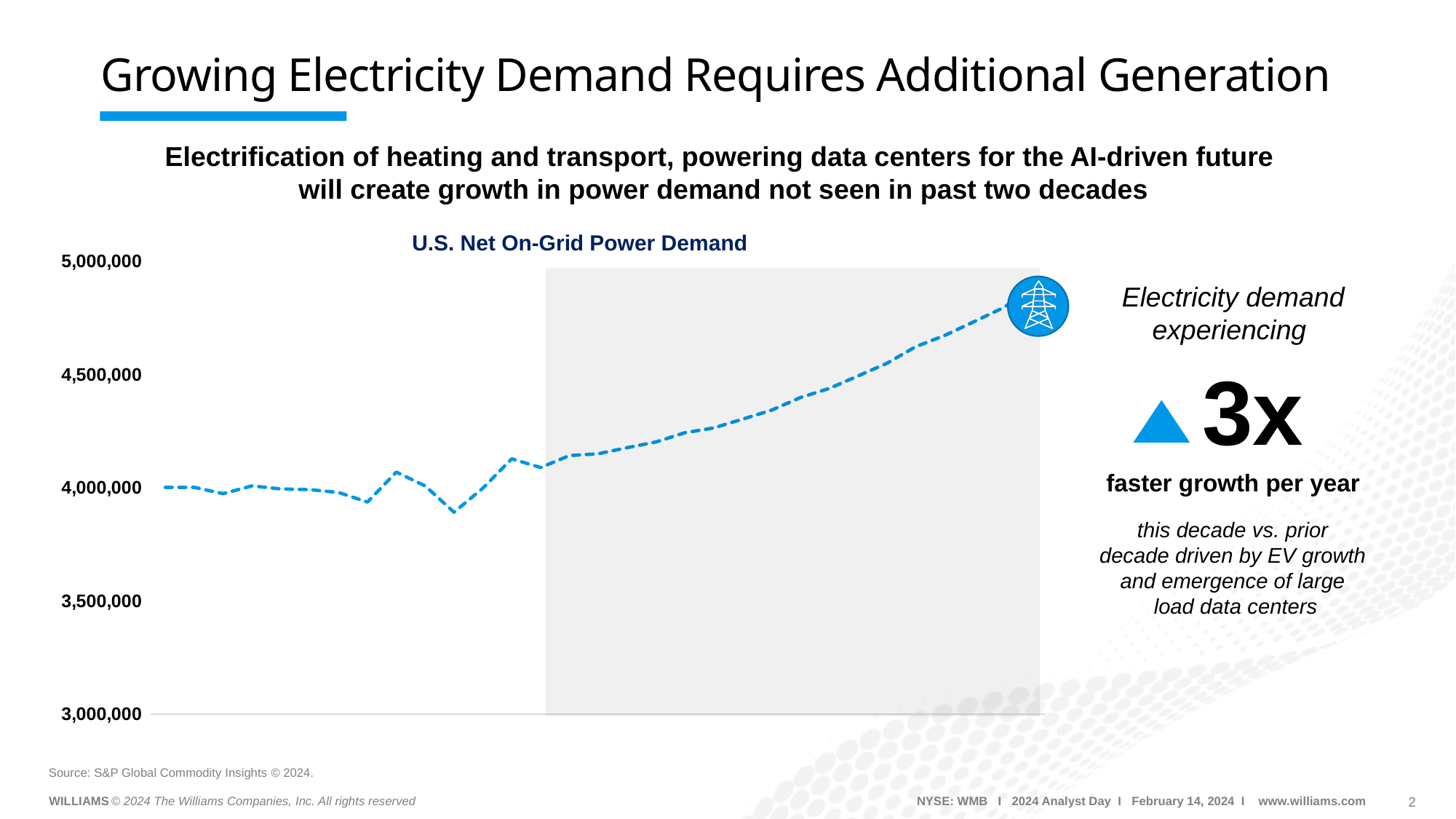
Is the value at the right end of the line greater or less than 4,500,000? greater Is the value at the left end of the line greater or less than 3,500,000? greater Do the values in the U.S. Net On-Grid Power Demand chart generally rise or fall from left to right? Rise What kind of chart is shown on the slide? Line chart What is the highest value shown on the y-axis of the chart? 5,000,000 Is the lowest point of the line greater or less than 3,500,000? greater Which end of the line is higher, the left end or the right end? The right end What is the title of the chart? U.S. Net On-Grid Power Demand